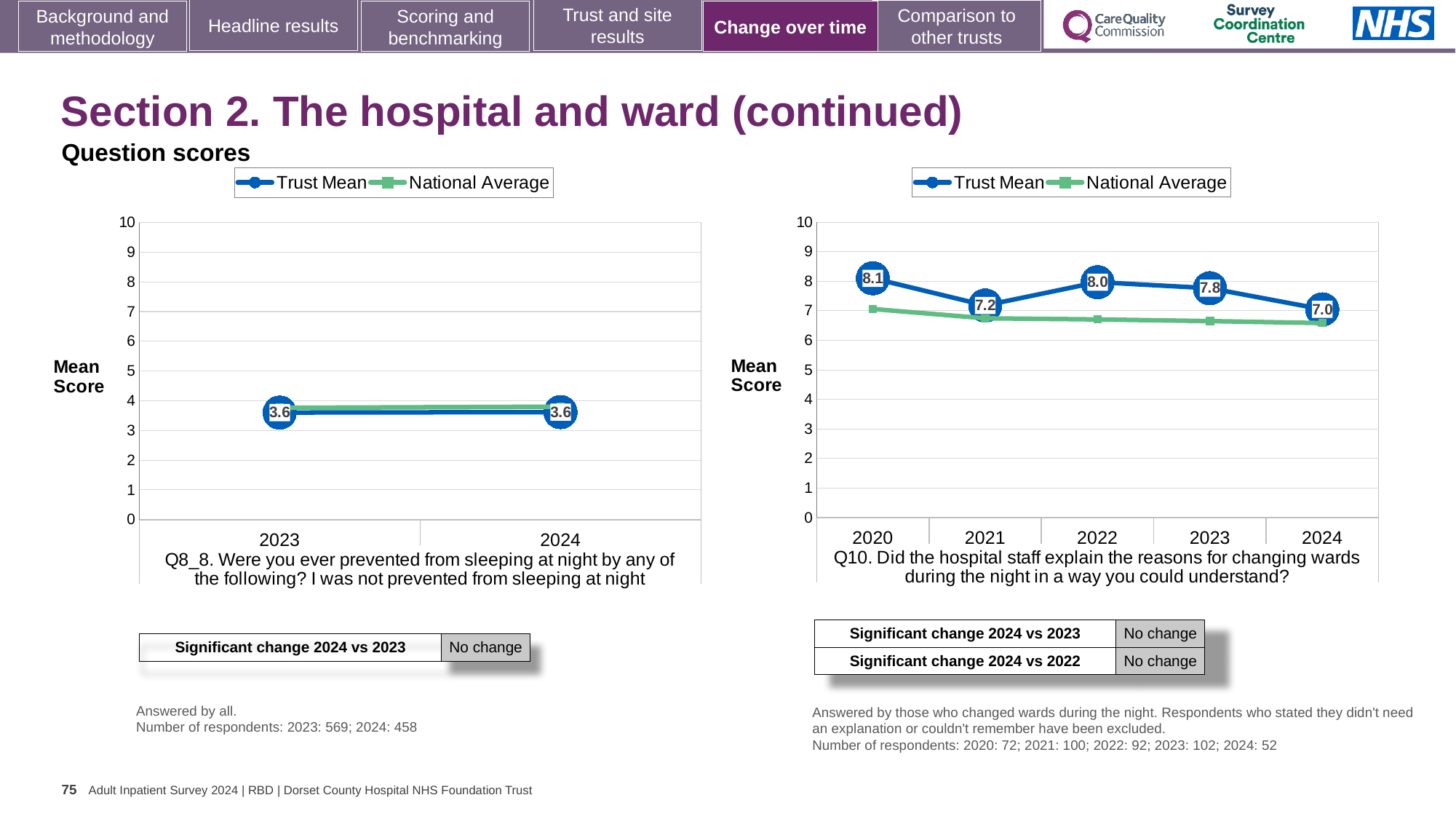
How many series does the legend of the Q8_8 chart on the left list? 2 How many years are shown on the x axis of the Q10 chart on the right? 5 In the Q10 chart on the right, what is the Trust Mean score for 2024? 7.0 In the Q10 chart on the right, which year has the lowest Trust Mean score? 2024 What kind of chart is the Q10 chart on the right? Line chart In the Q8_8 chart on the left, what is the Trust Mean score for 2023? 3.6 In the Q10 chart on the right, which year has the highest Trust Mean score? 2020 In the Q10 chart on the right, is the Trust Mean score higher in 2022 or in 2023? 2022 In the Q10 chart on the right, what is the Trust Mean score for 2020? 8.1 In the Q8_8 chart on the left, what is the Trust Mean score for 2024? 3.6 In the Q10 chart on the right, what is the difference between the Trust Mean scores for 2022 and 2021? 0.8 In the Q10 chart on the right, is the National Average value for 2024 greater or less than 8? less